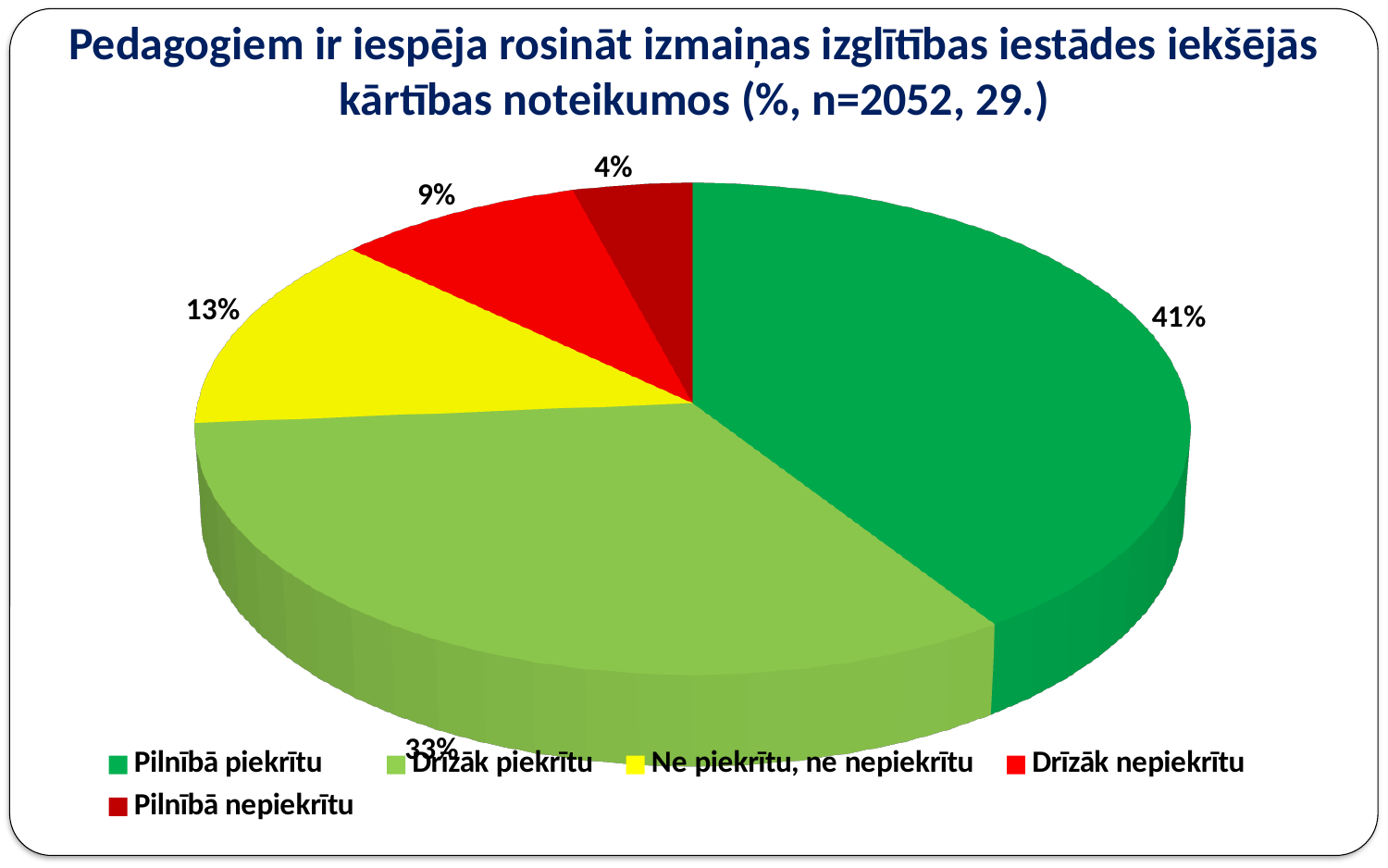
How many categories does the legend list? 5 What percentage of respondents answered "Pilnībā nepiekrītu"? 4% What percentage of respondents answered "Pilnībā piekrītu"? 41% What percentage of respondents answered "Drīzāk piekrītu"? 33% Which is larger, the share for "Ne piekrītu, ne nepiekrītu" or the share for "Drīzāk nepiekrītu"? Ne piekrītu, ne nepiekrītu Which response category has the smallest share of the pie? Pilnībā nepiekrītu What is the difference in percentage points between "Pilnībā piekrītu" and "Drīzāk piekrītu"? 8 Which response category has the largest share of the pie? Pilnībā piekrītu What percentage of respondents answered "Drīzāk nepiekrītu"? 9% What is the sample size (n) stated in the chart title? 2052 What percentage of respondents answered "Ne piekrītu, ne nepiekrītu"? 13% What type of chart is shown on the slide? pie chart